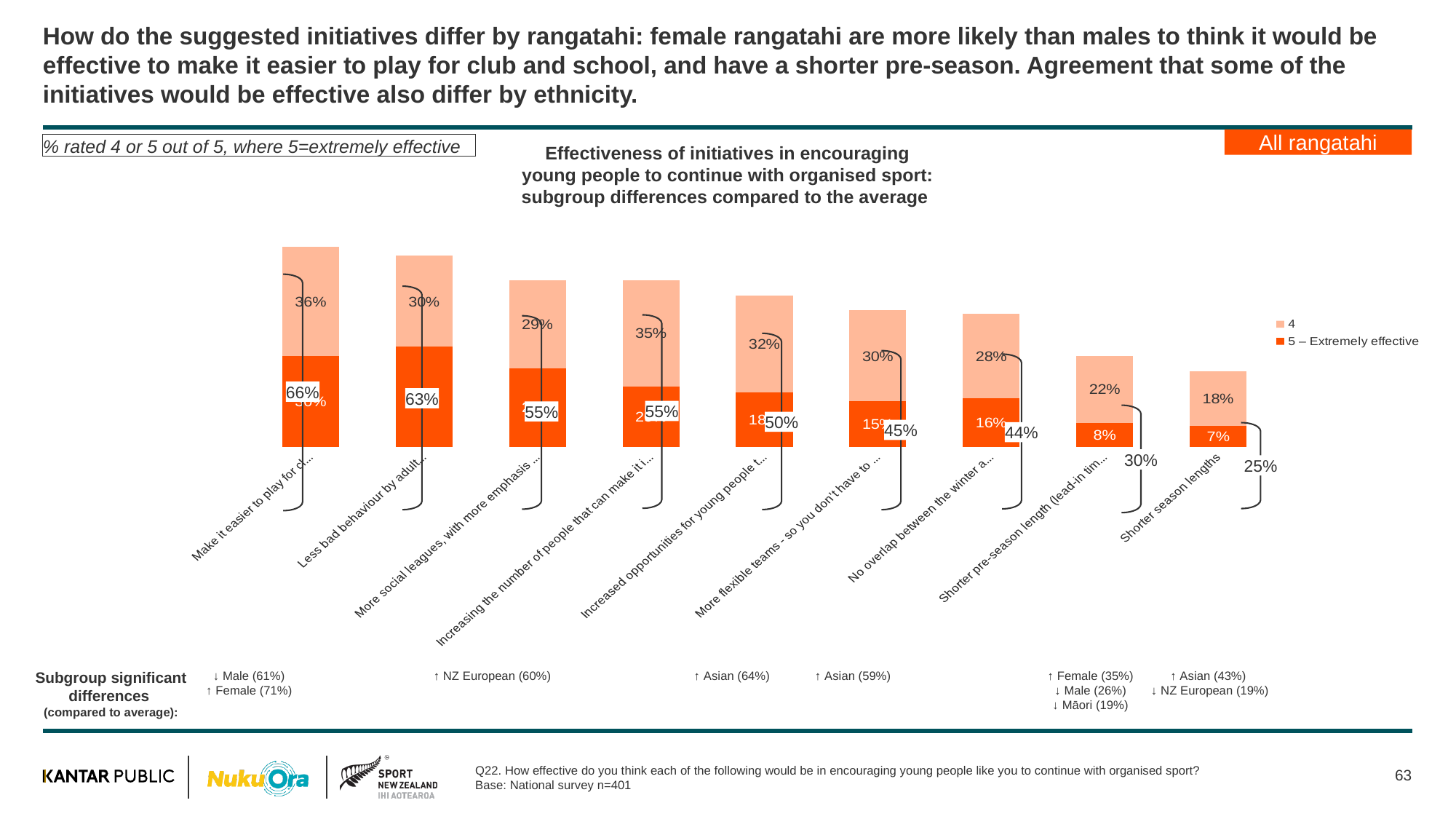
Do the combined totals (4 or 5) rise or fall moving from left to right across the chart? Fall Which has the larger '4' series value: 'Increasing the number of people that can make it i...' or 'Increased opportunities for young people t...'? Increasing the number of people that can make it i... (35%) How many initiatives (categories) are plotted on the chart? 9 What is the combined (4 or 5) total shown for 'Make it easier to play for cl...'? 66% Which initiative has the lowest '5 – Extremely effective' value? Shorter season lengths (7%) What is the '5 – Extremely effective' value for 'Shorter pre-season length (lead-in tim...)'? 8% What kind of chart is shown on the slide? Stacked bar chart How many series does the chart legend list? 2 Which initiative has the highest value for the '4' series? Make it easier to play for cl... (36%) What is the difference between the '4' series values for 'Shorter pre-season length (lead-in tim...)' and 'Shorter season lengths'? 4 percentage points What is the value of the '4' series for 'Shorter season lengths'? 18% What are the two entries in the chart legend? 4 and 5 – Extremely effective